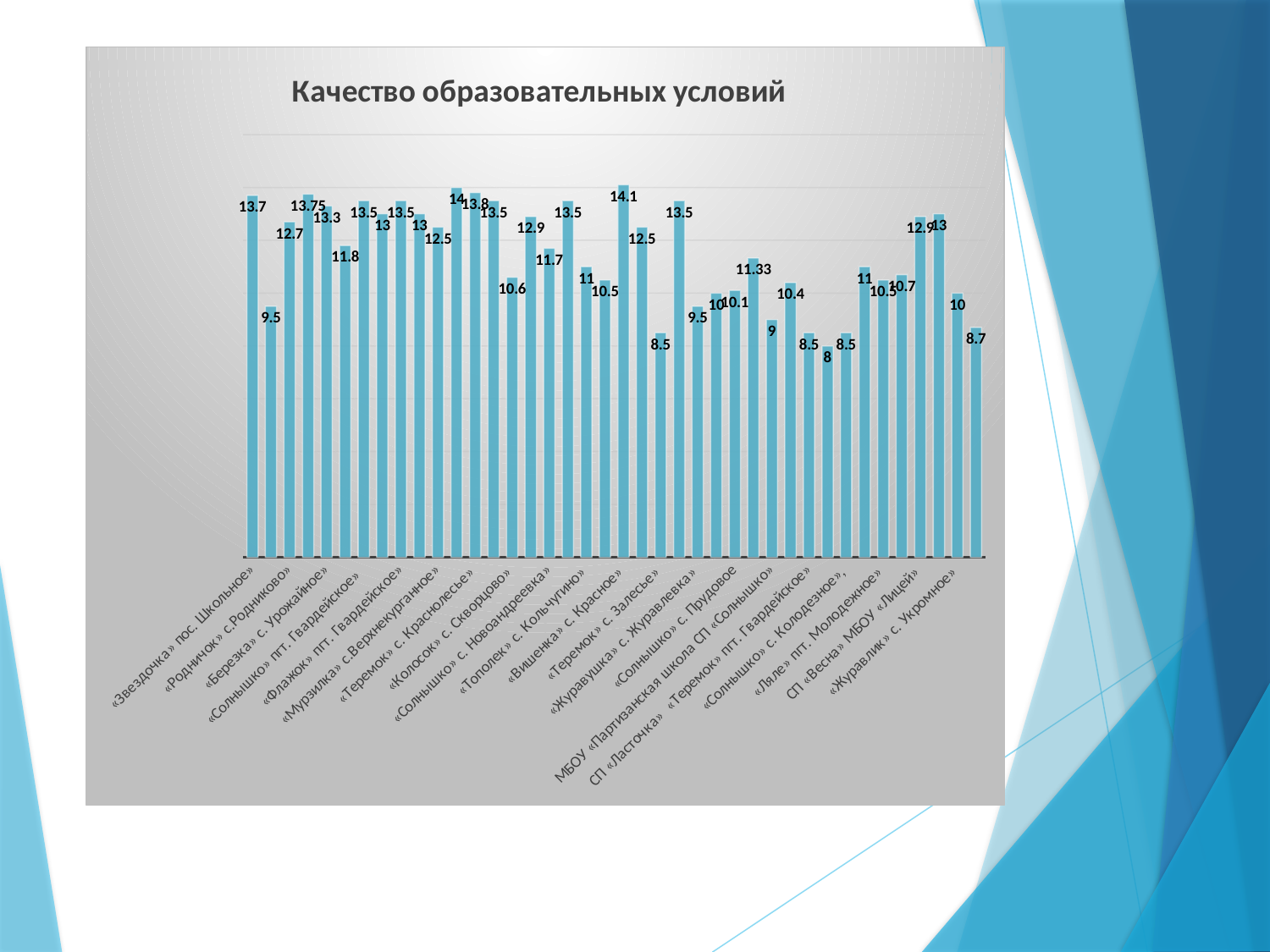
What colour are the bars on the chart? light blue What is the lowest value shown on the chart? 8 What is the value for «Звездочка» пос. Школьное, the first category on the chart? 13.7 Which is larger: the value for the first bar («Звездочка» пос. Школьное, 13.7) or the highest bar on the chart (14.1)? 14.1 How many bars on the chart have a value of exactly 8? 1 What is the title of the chart? Качество образовательных условий What is the highest value shown on the chart? 14.1 What is the value of the second bar on the chart, immediately after the 13.7 bar? 9.5 What kind of chart is shown on the slide? bar chart What is the difference between the highest value (14.1) and the lowest value (8) on the chart? 6.1